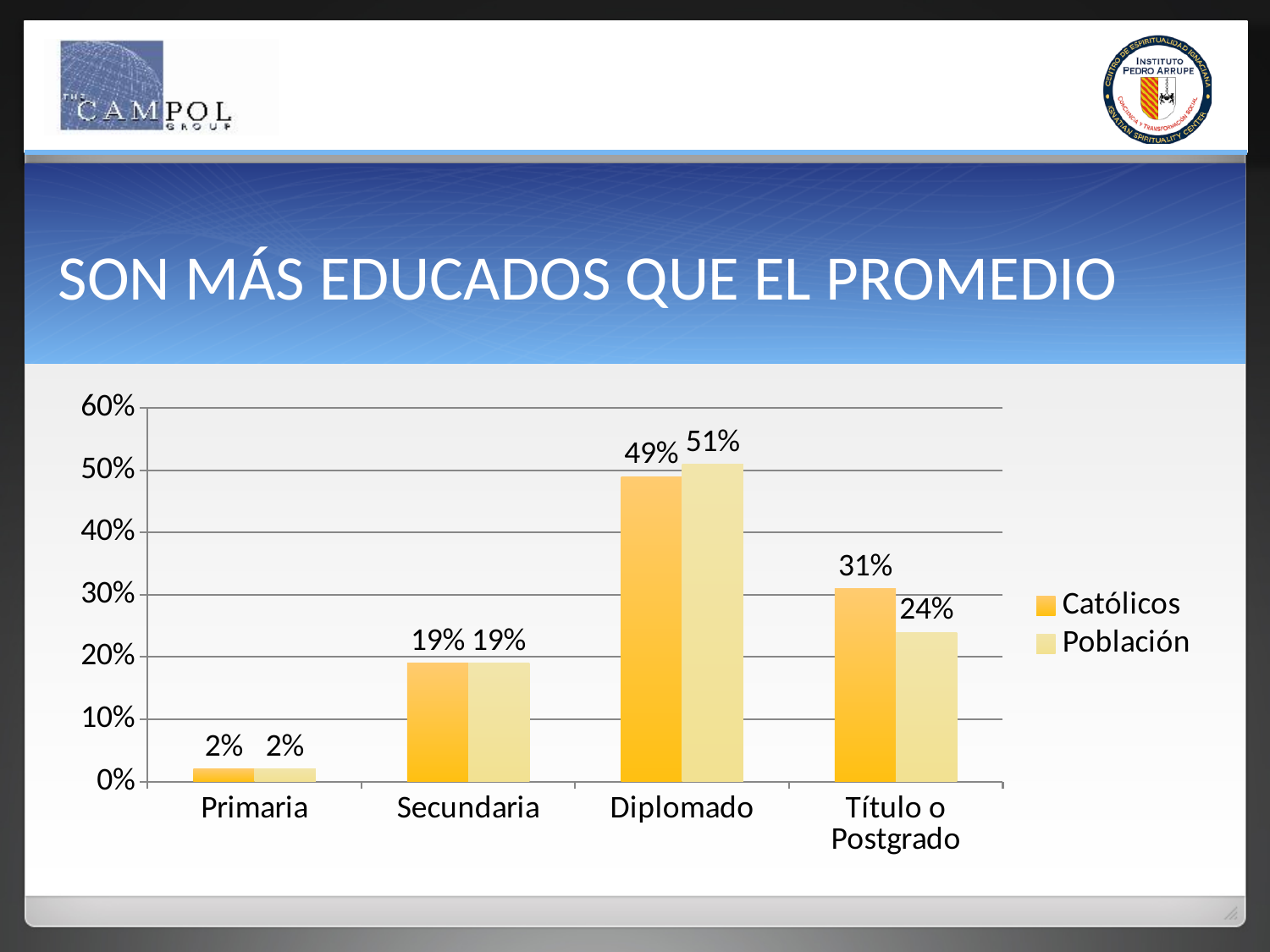
How many series does the legend list? 2 Which category has the lowest value for Católicos? Primaria Which is larger in the Título o Postgrado category, Católicos or Población? Católicos How many categories are shown on the x axis? 4 What is the value for Católicos in the Diplomado category? 49% What is the value for Población in the Título o Postgrado category? 24% What kind of chart is shown on the slide? bar chart Is the value for Católicos in Diplomado greater or less than 40%? greater What is the difference between Población and Católicos in the Diplomado category? 2% What is the value for Católicos in the Secundaria category? 19% What is the difference between Católicos and Población in the Título o Postgrado category? 7% Which category has the highest value for Población? Diplomado